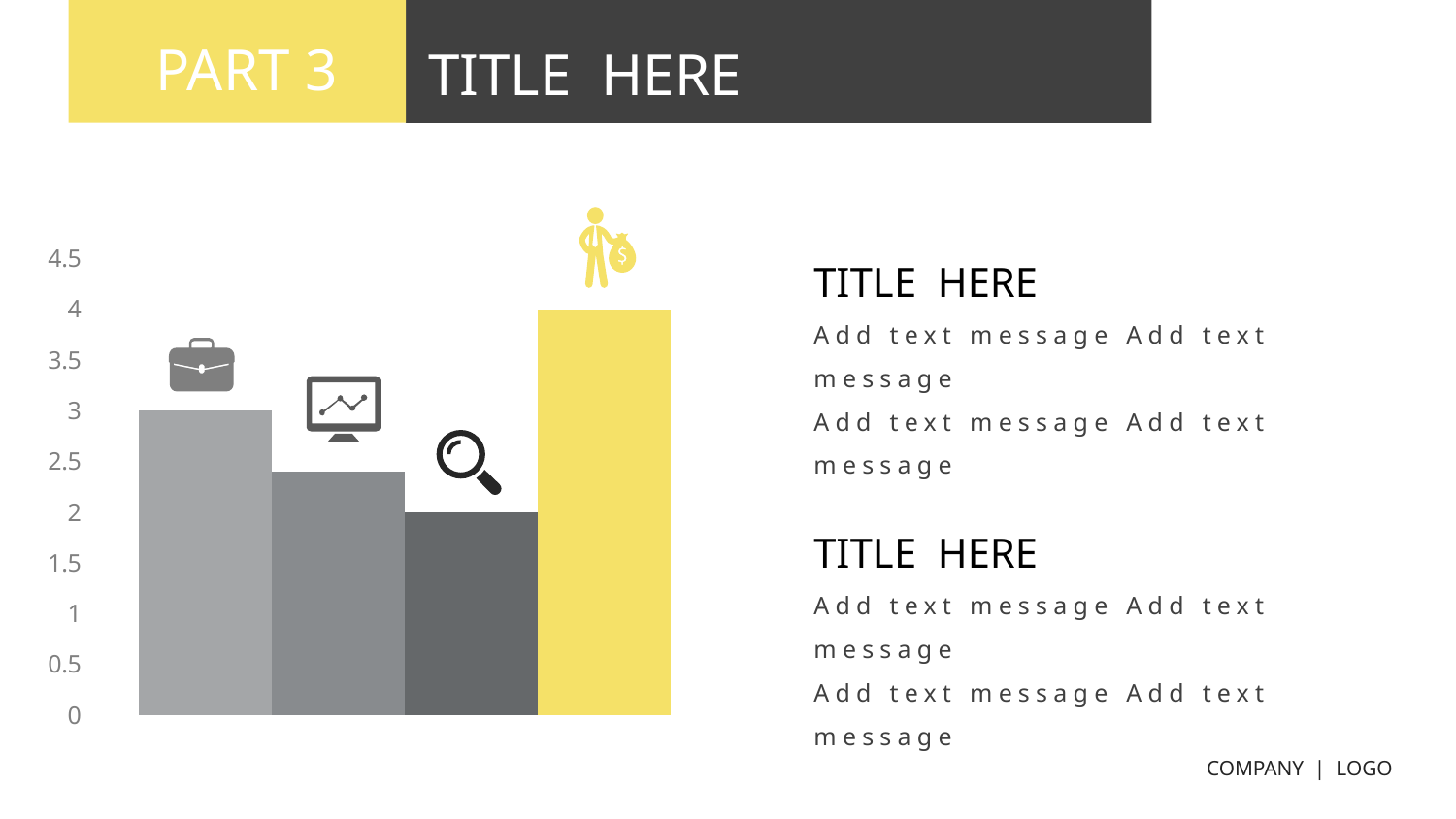
Which bar is the tallest in the chart? the fourth (yellow) bar What kind of chart is shown on the slide? bar chart How many bars does the chart contain? 4 Which bar is the shortest in the chart? the third bar What value does the third bar from the left reach on the axis? 2 What is the difference between the fourth bar and the first bar? 1 Which is larger, the first bar or the second bar? the first bar What value does the first bar from the left reach on the axis? 3 What value does the fourth (yellow) bar reach on the axis? 4 Is the value of the second bar from the left greater or less than 2? greater What colour is the tallest bar in the chart? yellow